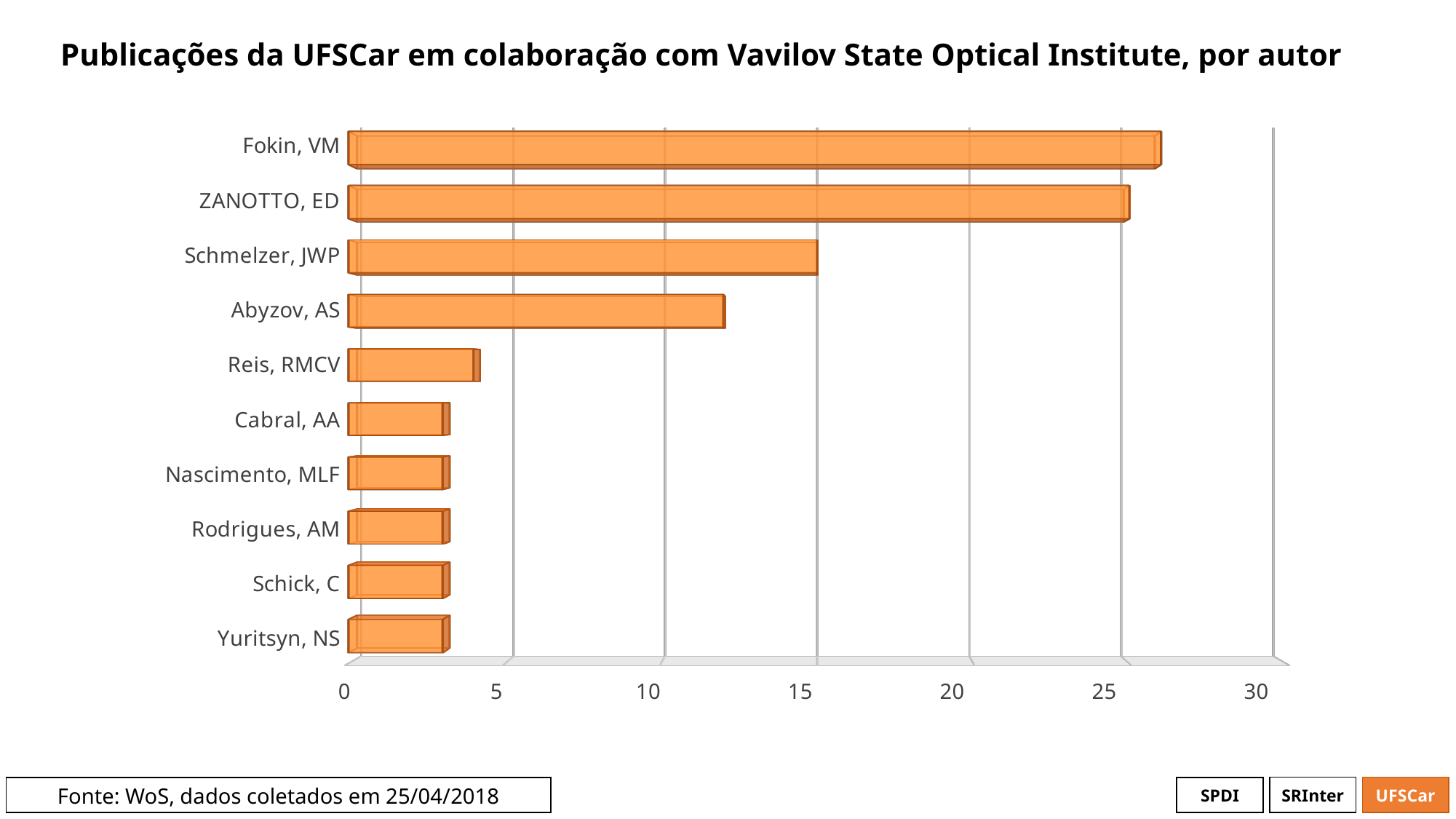
Is the value for Fokin, VM greater or less than 25? greater Which has more publications, Schmelzer, JWP or Abyzov, AS? Schmelzer, JWP Which author has the highest number of publications? Fokin, VM Is the value for Abyzov, AS greater or less than 15? less Is the value for Reis, RMCV greater or less than 5? less What is the title of the chart? Publicações da UFSCar em colaboração com Vavilov State Optical Institute, por autor What kind of chart is shown on the slide? bar chart How many authors are listed on the chart? 10 Which has more publications, ZANOTTO, ED or Reis, RMCV? ZANOTTO, ED